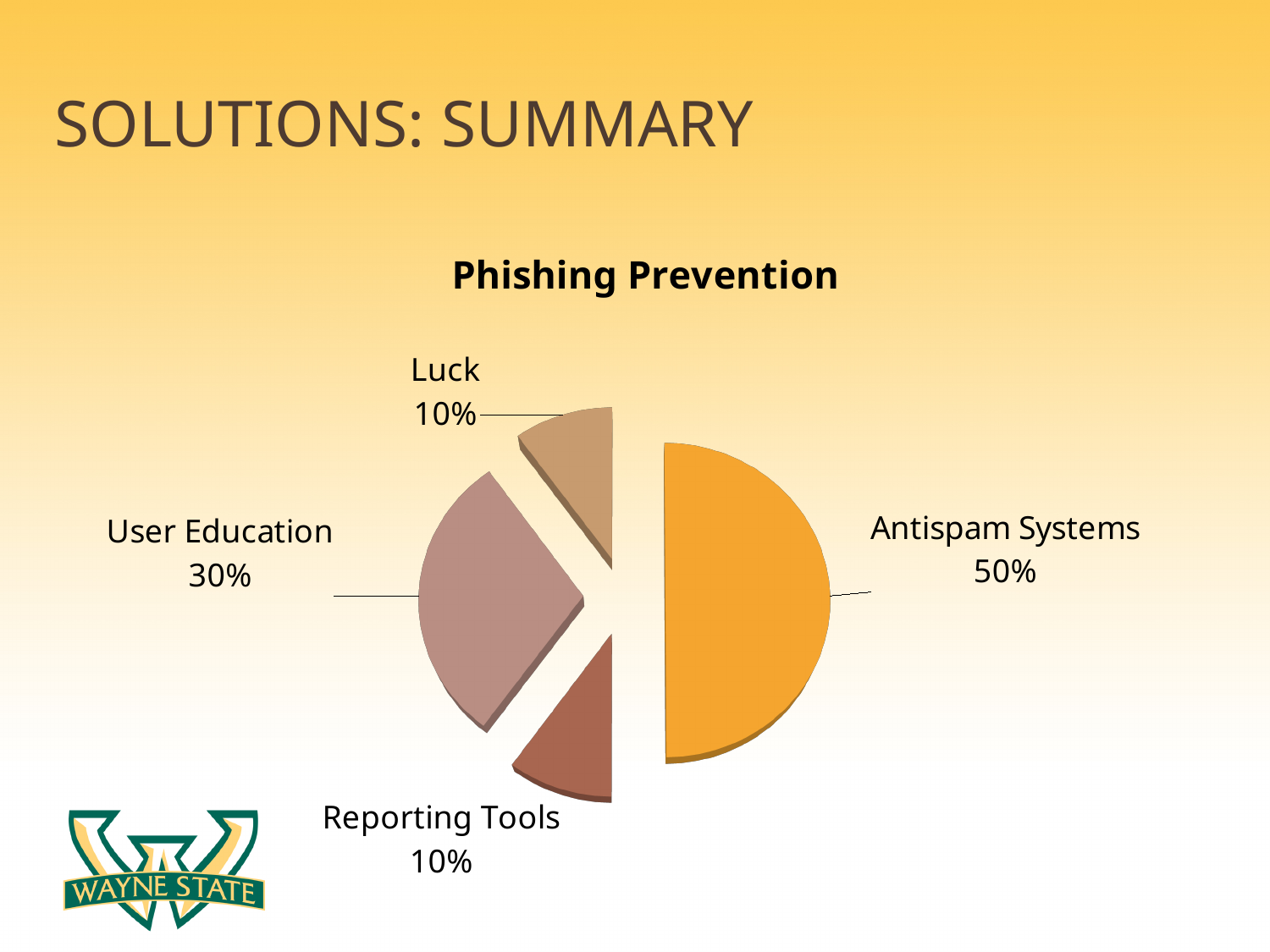
What colour is the Antispam Systems slice? Orange What is the value shown for Luck? 10% Which category has the largest slice of the pie? Antispam Systems What share of the pie does Antispam Systems represent? 50% What is the title of the chart? Phishing Prevention What is the value shown for User Education? 30% What is the combined share of Luck and Reporting Tools? 20% What is the difference between the Antispam Systems and User Education shares? 20% What kind of chart is shown on the slide? Pie chart What is the value shown for Reporting Tools? 10% Which is larger, the User Education slice or the Luck slice? User Education How many categories are shown in the pie chart? 4